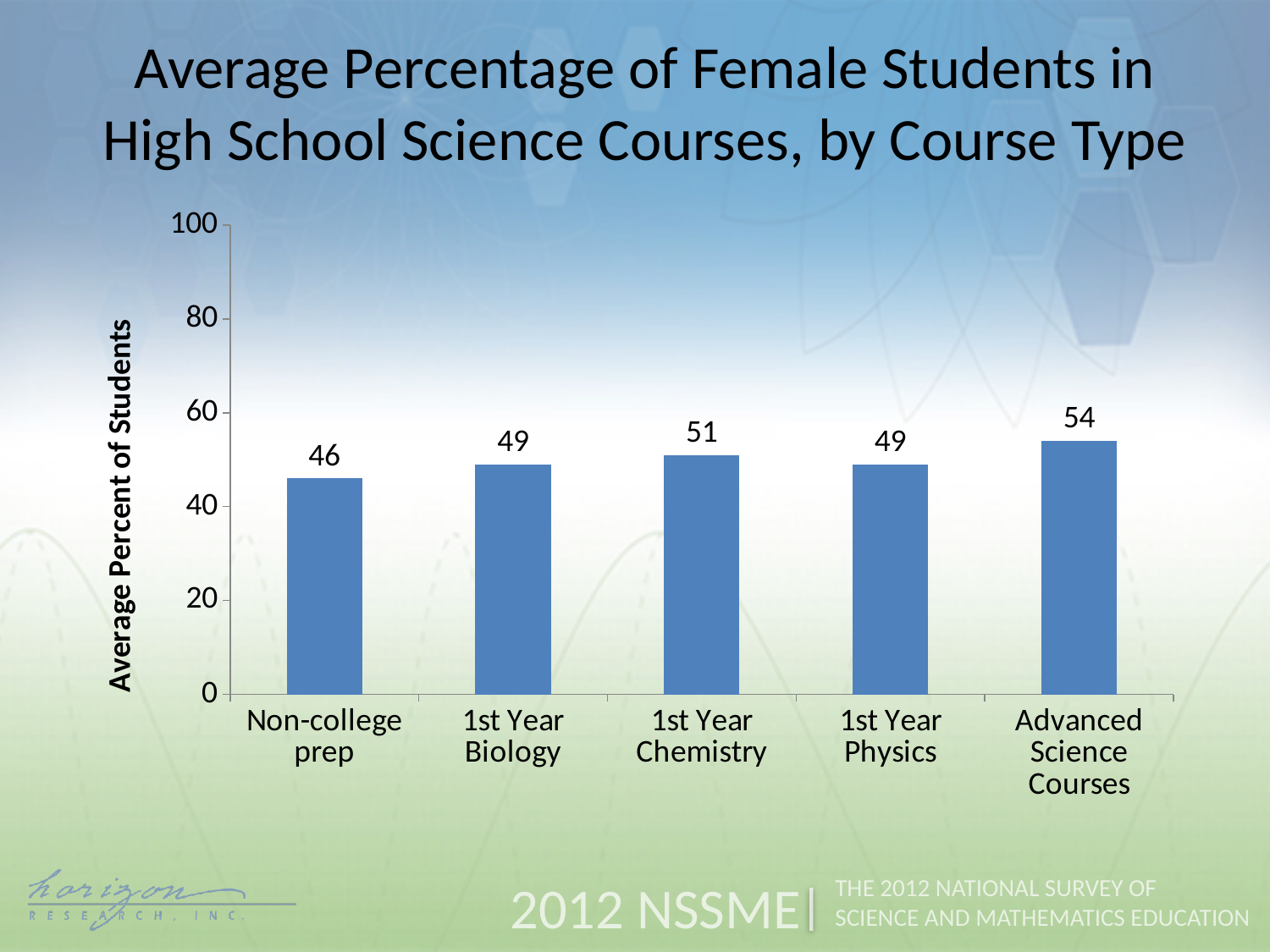
How many course types are shown on the chart? 5 Which is larger, the value for 1st Year Chemistry or the value for 1st Year Physics? 1st Year Chemistry Is the value for Non-college prep greater or less than 40? greater What is the average percent of female students in 1st Year Chemistry? 51 What is the difference between the values for 1st Year Chemistry and 1st Year Biology? 2 What is the average percent of female students in Non-college prep courses? 46 Which course type has the highest average percent of female students? Advanced Science Courses What is the label of the vertical axis? Average Percent of Students Which course type has the lowest average percent of female students? Non-college prep What kind of chart is shown on the slide? Bar chart What is the average percent of female students in Advanced Science Courses? 54 What is the difference between the values for Advanced Science Courses and Non-college prep? 8